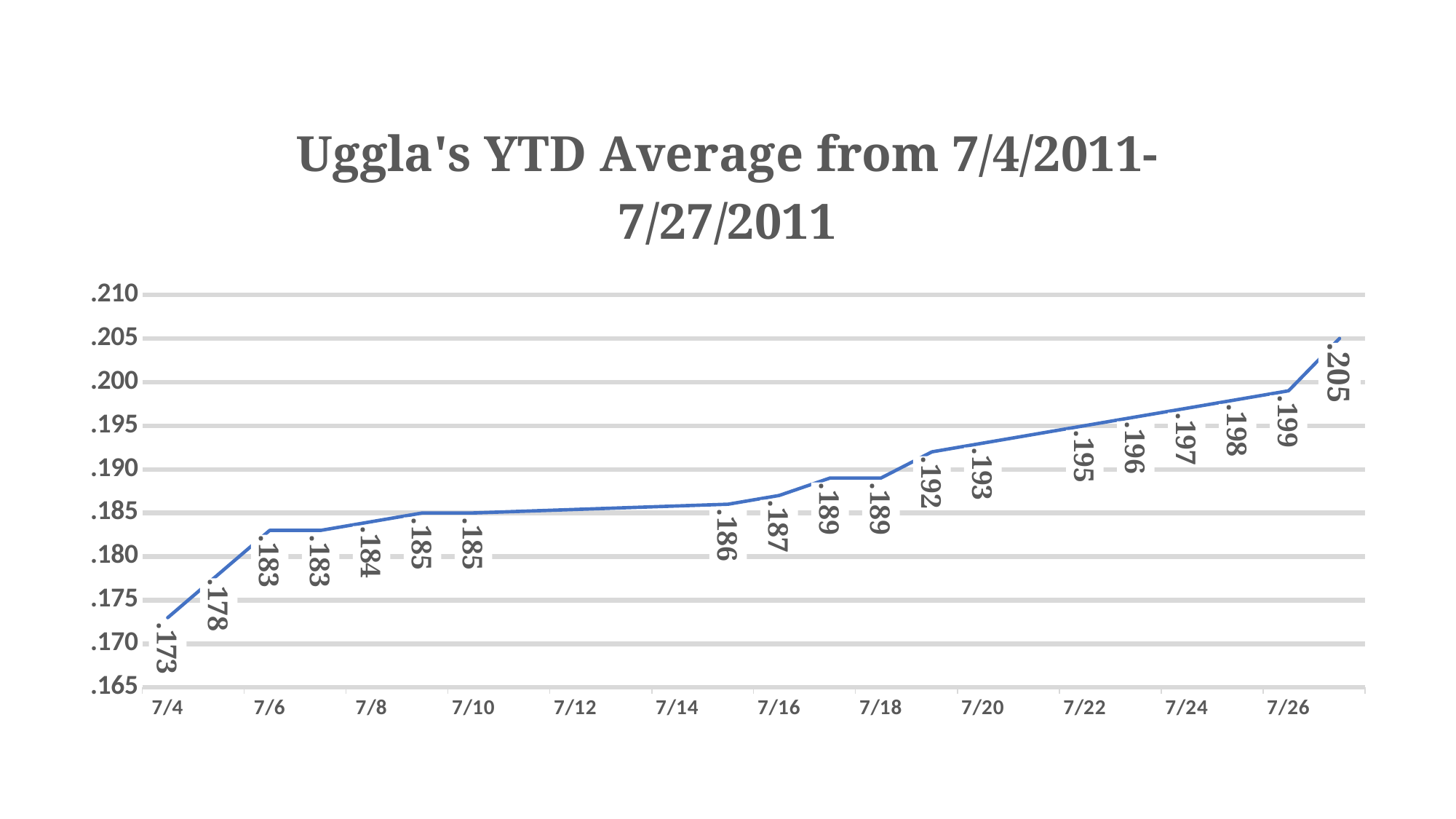
What is the difference between the YTD average on 7/27 and on 7/4? .032 What is Uggla's YTD average on 7/4? .173 What kind of chart is shown on the slide? line chart What is the YTD average labeled at 7/8? .184 Is the value for 7/12 greater or less than .190? less What is the YTD average labeled at 7/19? .192 What is the title of the chart? Uggla's YTD Average from 7/4/2011-7/27/2011 Which is larger, the YTD average on 7/6 or on 7/16? 7/16 What is Uggla's YTD average on 7/27? .205 Does the YTD average generally rise or fall from 7/4 to 7/27? rise On which date is the YTD average lowest? 7/4 On which date is the YTD average highest? 7/27